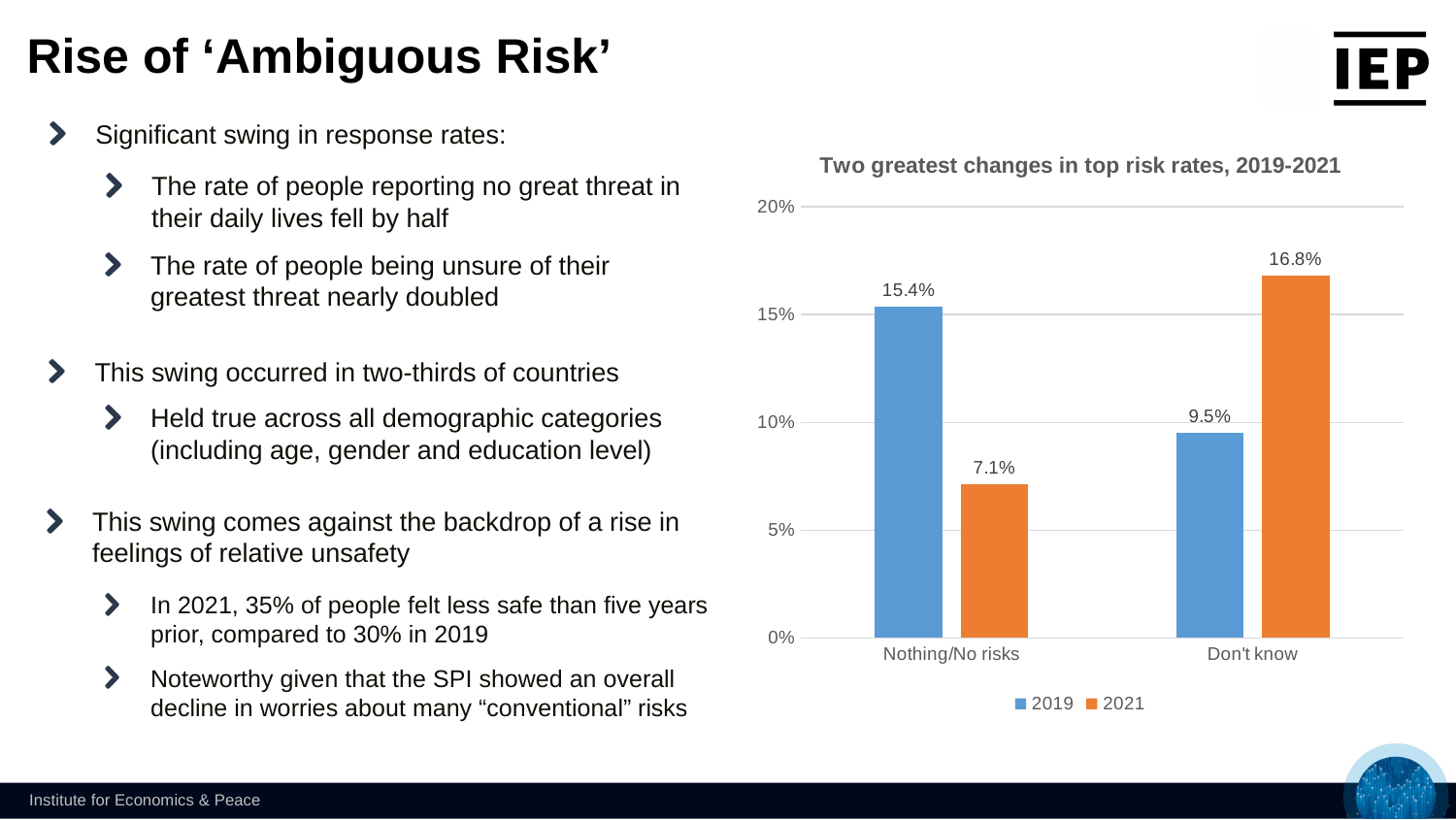
Which category has the highest 2021 value? Don't know Which category has the lowest 2021 value? Nothing/No risks What kind of chart is shown on the slide? Bar chart How many categories are shown on the x axis? 2 How many series does the legend list? 2 Which is larger: the 2019 value for Nothing/No risks or the 2019 value for Don't know? Nothing/No risks What is the 2021 value for Nothing/No risks? 7.1% What is the difference between the 2019 and 2021 values for Nothing/No risks? 8.3% What is the 2021 value for Don't know? 16.8% What is the 2019 value for Nothing/No risks? 15.4% What is the 2019 value for Don't know? 9.5% What is the difference between the 2021 and 2019 values for Don't know? 7.3%